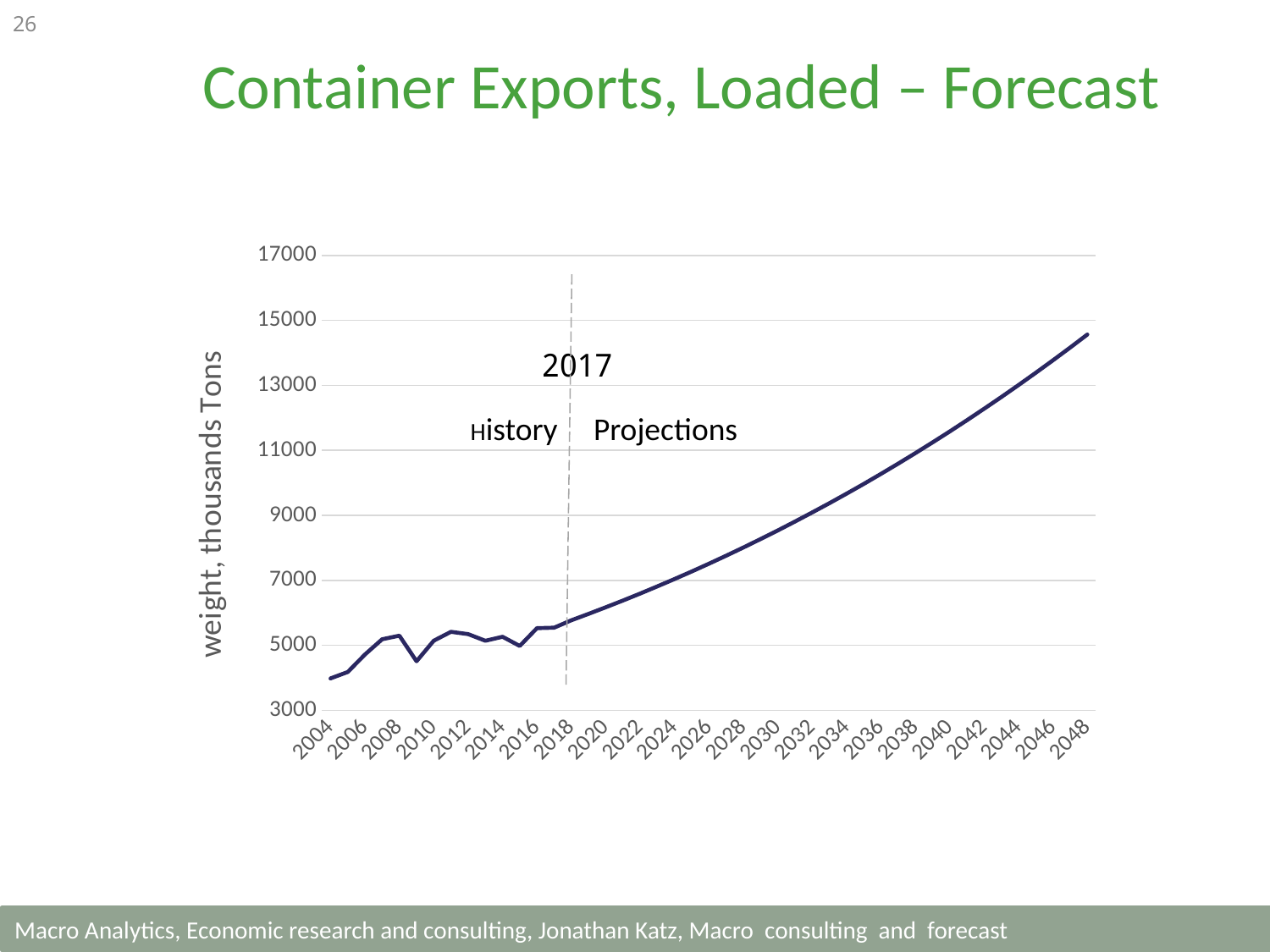
What is the label on the vertical axis of the chart? weight, thousands Tons What kind of chart is shown on the slide? line chart Which is larger, the value for 2009 or the value for 2012? 2012 Is the value for 2020 greater or less than 7000? less Which is larger, the value for 2004 or the value for 2048? 2048 Which year is the highest value on the chart? 2048 Is the value for 2004 greater or less than 5000? less Is the value for 2030 greater or less than 7000? greater What is the title of the chart? Container Exports, Loaded – Forecast Do the values rise or fall along the x axis in the projections period after 2017? rise Which year is the lowest value on the chart? 2004